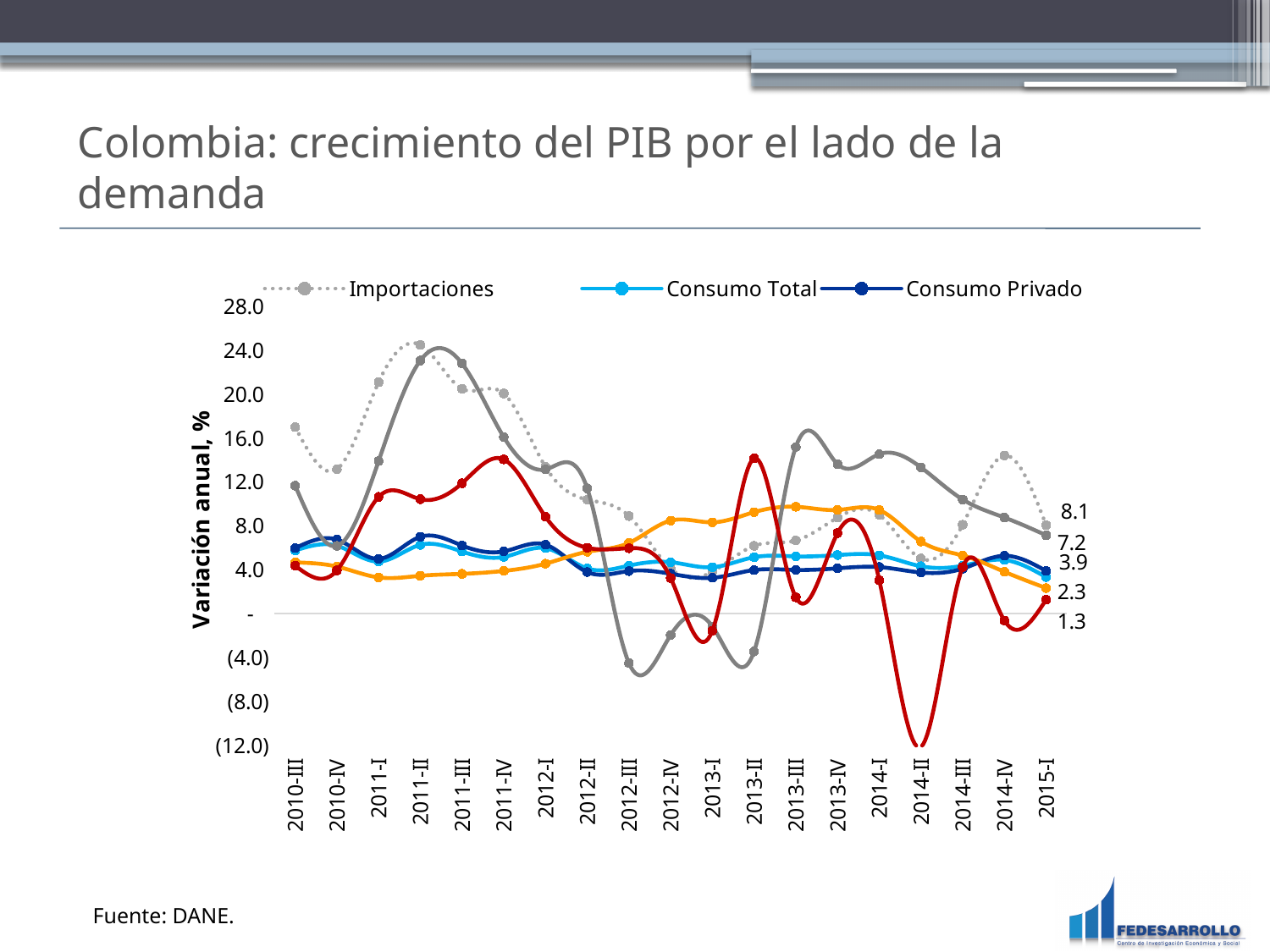
Is the value for Importaciones in 2010-III greater or less than 12.0? greater Which is larger for Importaciones, the value in 2010-III or the value in 2010-IV? 2010-III What kind of chart is shown on the slide? line chart What is the title of the slide containing the chart? Colombia: crecimiento del PIB por el lado de la demanda In which quarter does the Importaciones series reach its highest value? 2011-II Does the Importaciones series rise or fall between 2010-IV and 2011-II? rise How many series does the chart legend list? 3 How many quarters are labelled along the x axis of the chart? 19 Which is larger in 2011-II, Importaciones or Consumo Privado? Importaciones Is the value for Importaciones in 2014-IV greater or less than 12.0? greater Is the value for Consumo Privado in 2011-II greater or less than 4.0? greater What is the label on the vertical axis of the chart? Variación anual, %